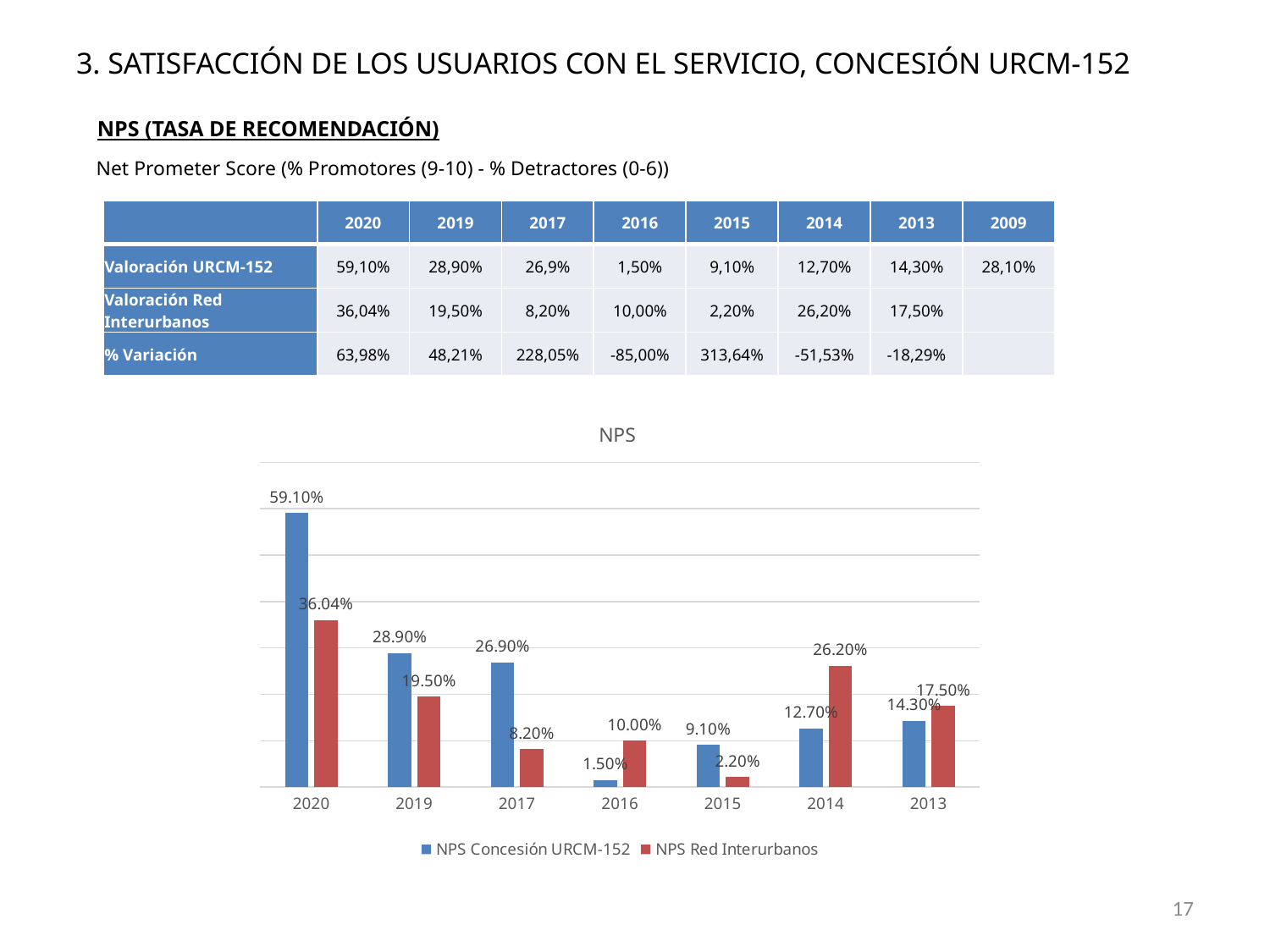
How many series does the chart legend list? 2 What type of chart is shown on the slide? bar chart Which year has the highest NPS Concesión URCM-152 value? 2020 In 2016, which series has the larger value, NPS Concesión URCM-152 or NPS Red Interurbanos? NPS Red Interurbanos What is the title of the chart? NPS What is the NPS Concesión URCM-152 value for 2016? 1.50% What is the difference between NPS Concesión URCM-152 and NPS Red Interurbanos in 2020? 23.06% What is the NPS Concesión URCM-152 value for 2020? 59.10% How many years are shown on the x axis of the NPS chart? 7 Which year has the lowest NPS Red Interurbanos value? 2015 What is the NPS Red Interurbanos value for 2014? 26.20% What is the difference between NPS Red Interurbanos and NPS Concesión URCM-152 in 2014? 13.50%